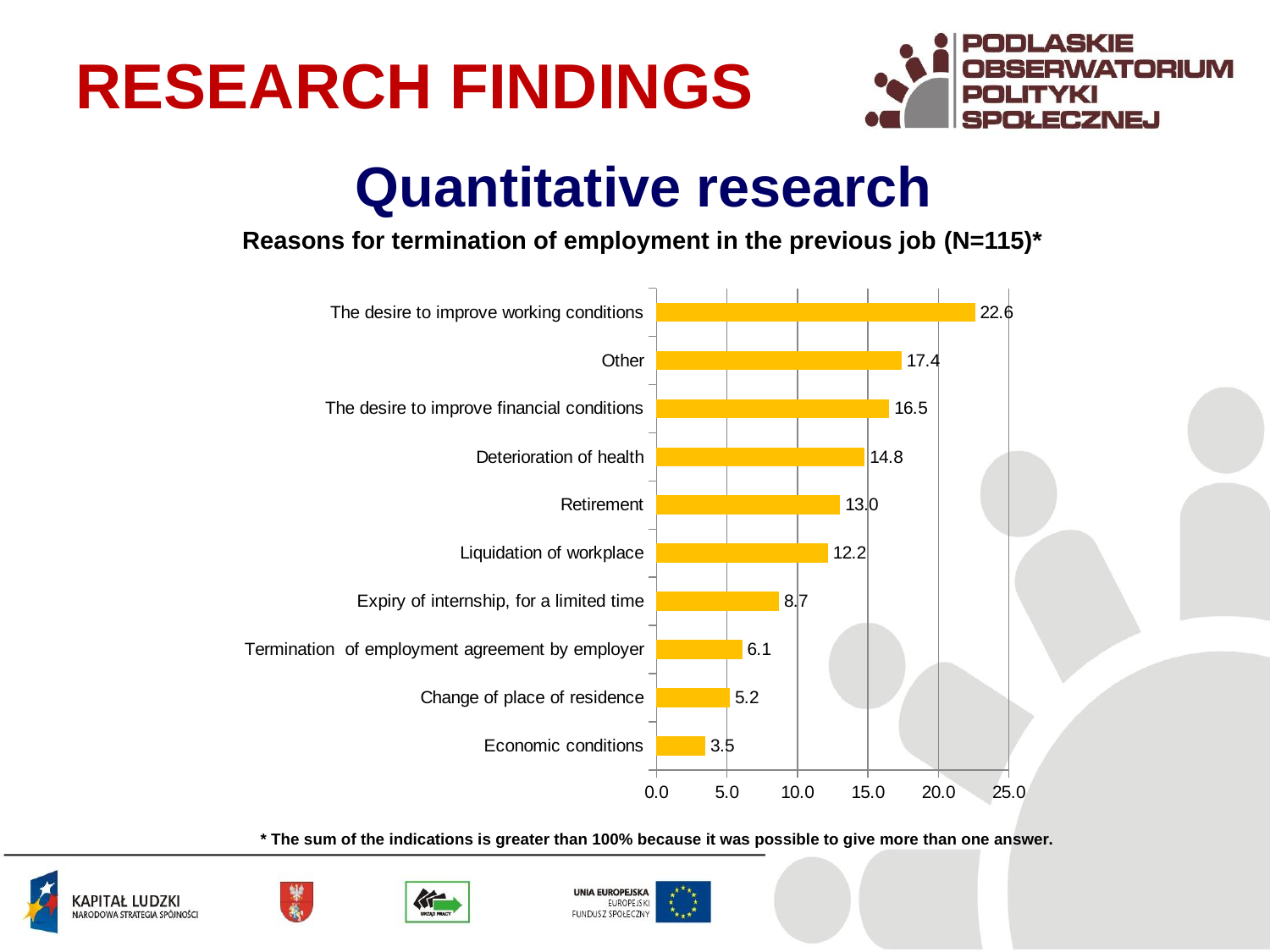
What is the difference between 'Termination of employment agreement by employer' and 'Economic conditions'? 2.6 Which reason has the highest value? The desire to improve working conditions What kind of chart is shown on the slide? Bar chart What is the value for 'The desire to improve working conditions'? 22.6 Is the value for 'Expiry of internship, for a limited time' greater or less than 10.0? less Which reason has the lowest value? Economic conditions What is the title of the chart? Reasons for termination of employment in the previous job (N=115)* What is the difference between 'Other' and 'The desire to improve financial conditions'? 0.9 What is the value for 'Change of place of residence'? 5.2 Which is larger: 'Deterioration of health' or 'Liquidation of workplace'? Deterioration of health How many reasons are shown in the chart? 10 What is the value for 'Retirement'? 13.0